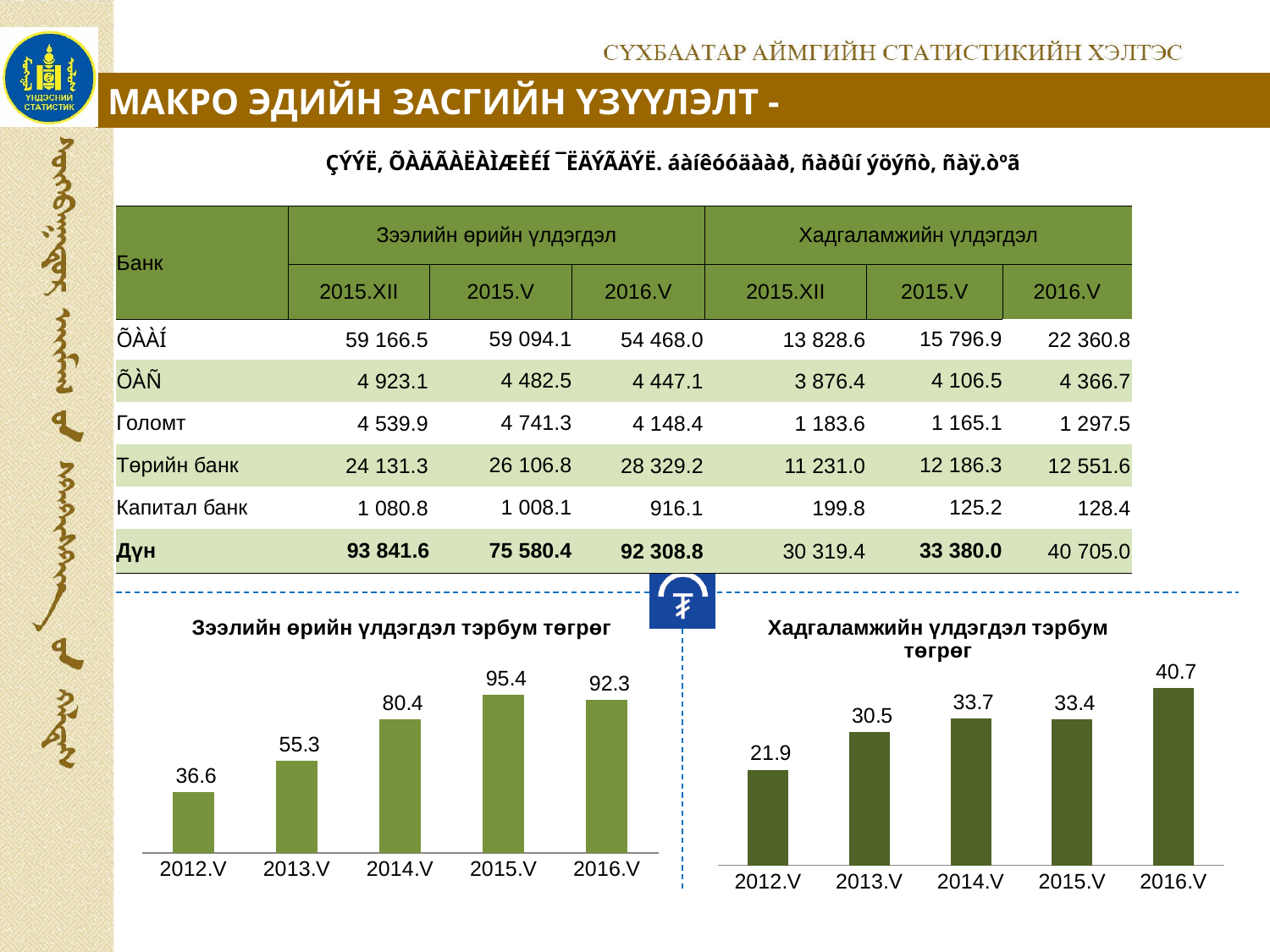
In the left chart 'Зээлийн өрийн үлдэгдэл тэрбум төгрөг', which year has the highest value? 2015.V In the right chart 'Хадгаламжийн үлдэгдэл тэрбум төгрөг', what is the difference between the values for 2016.V and 2015.V? 7.3 In the left chart 'Зээлийн өрийн үлдэгдэл тэрбум төгрөг', which is larger, the value for 2013.V or 2014.V? 2014.V In the right chart 'Хадгаламжийн үлдэгдэл тэрбум төгрөг', which year has the highest value? 2016.V In the left chart 'Зээлийн өрийн үлдэгдэл тэрбум төгрөг', what is the difference between the values for 2015.V and 2016.V? 3.1 In the right chart 'Хадгаламжийн үлдэгдэл тэрбум төгрөг', which year has the lowest value? 2012.V In the left chart 'Зээлийн өрийн үлдэгдэл тэрбум төгрөг', do the values rise or fall from 2012.V to 2015.V? Rise How many bars are shown in the right chart 'Хадгаламжийн үлдэгдэл тэрбум төгрөг'? 5 In the right chart 'Хадгаламжийн үлдэгдэл тэрбум төгрөг', what is the value for 2012.V? 21.9 What is the title of the right chart on the slide? Хадгаламжийн үлдэгдэл тэрбум төгрөг In the left chart 'Зээлийн өрийн үлдэгдэл тэрбум төгрөг', what is the value for 2014.V? 80.4 What type of chart is the left chart 'Зээлийн өрийн үлдэгдэл тэрбум төгрөг'? Bar chart